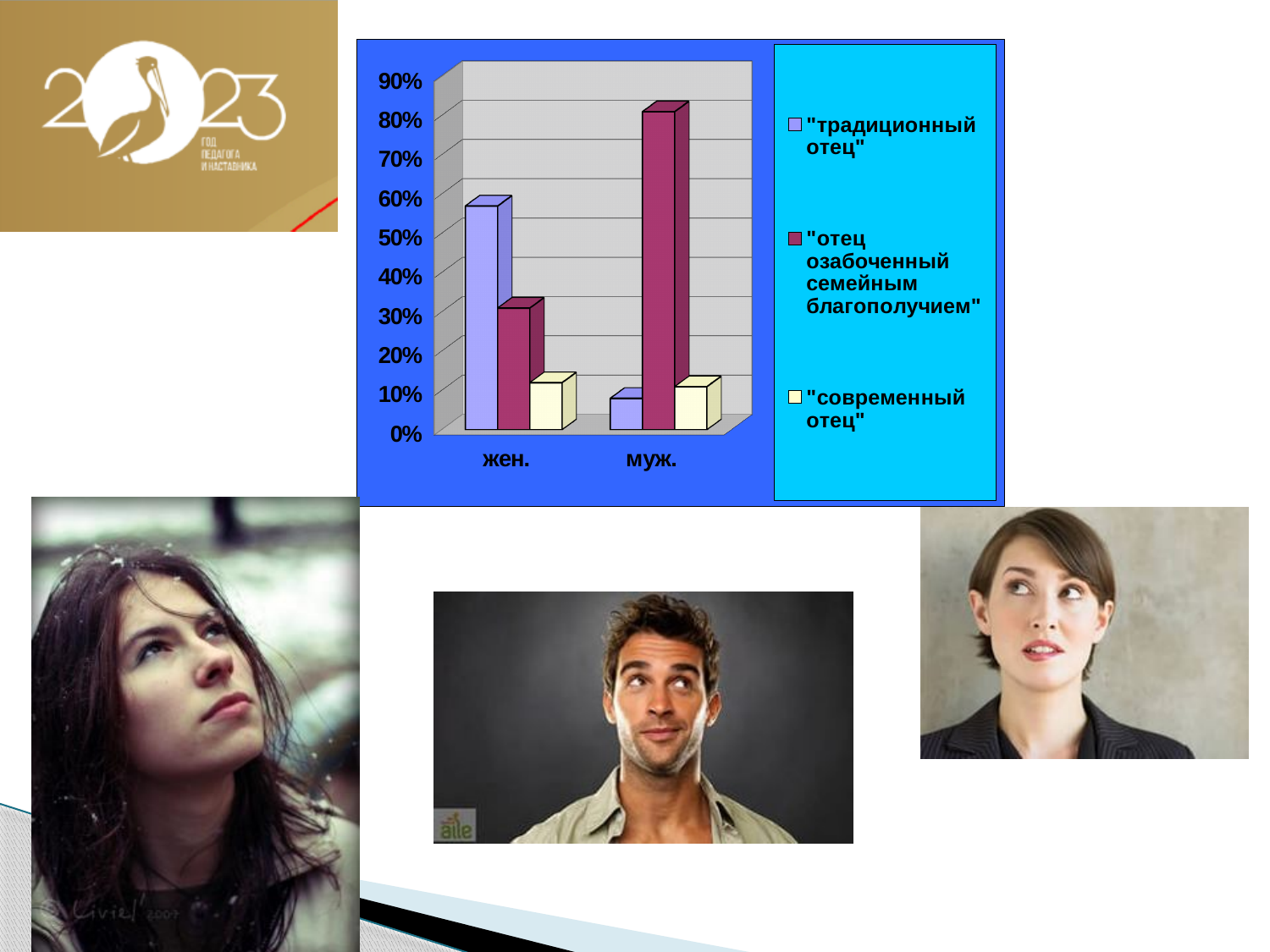
Is the value of "отец озабоченный семейным благополучием" for жен. greater or less than 40%? less What colour are the bars for the series "современный отец"? light yellow How many categories are shown on the x axis of the chart? 2 Which category has the larger value for "традиционный отец", жен. or муж.? жен. Is the value of "традиционный отец" for муж. greater or less than 20%? less Which series has the highest value for the category муж.? "отец озабоченный семейным благополучием" Is the value of "традиционный отец" for жен. greater or less than 50%? greater Which series has the lowest value for the category жен.? "современный отец" What kind of chart is shown on the slide? bar chart How many series does the chart's legend list? 3 Which series has the highest value for the category жен.? "традиционный отец"